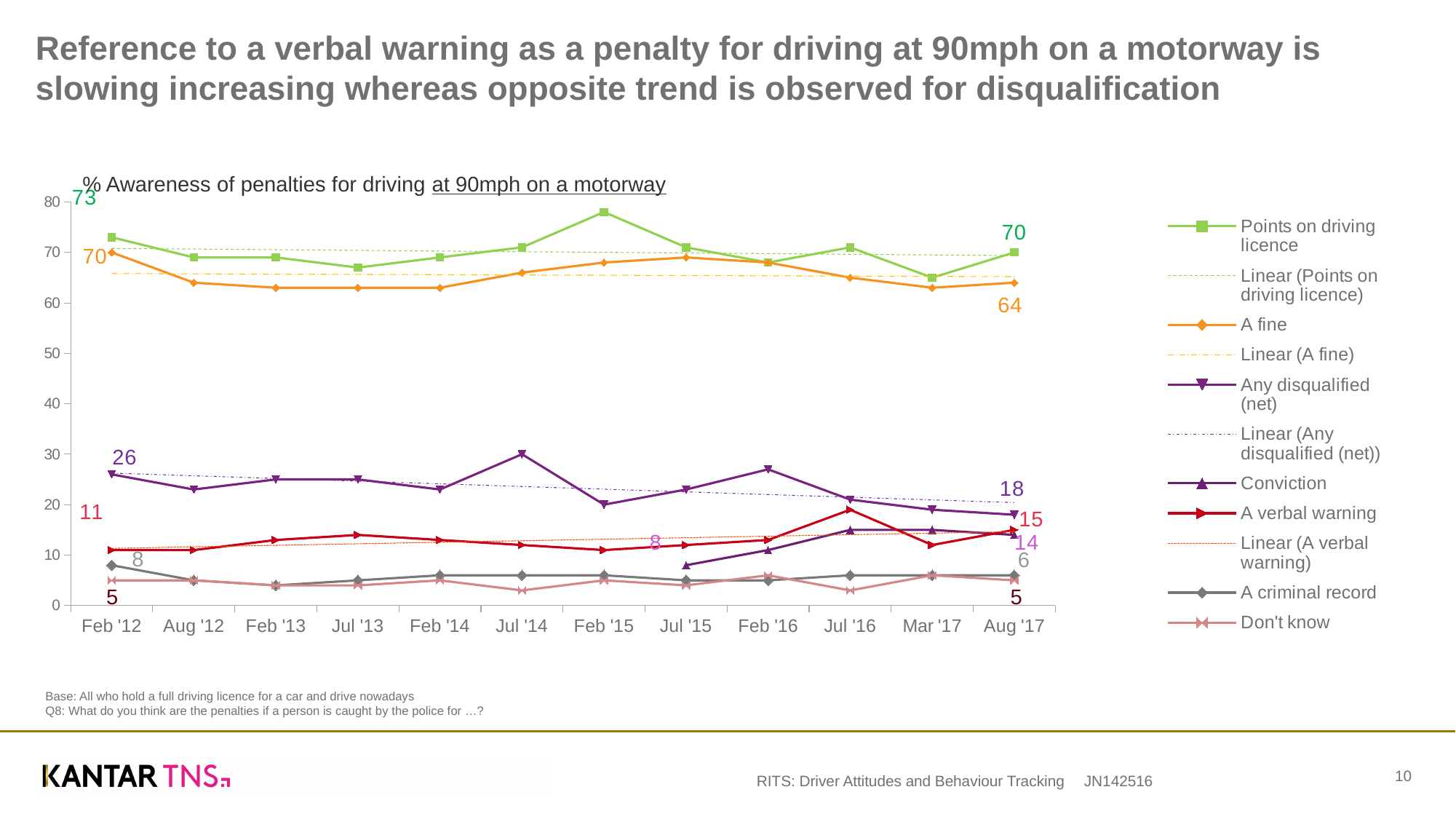
What is the value for Points on driving licence in Feb '12? 73 What is the difference between the Any disqualified (net) values in Feb '12 and Aug '17? 8 Is the value for Points on driving licence in Feb '15 greater or less than 70? greater What is the value for A fine in Aug '17? 64 How many time points are shown on the x axis? 12 How many entries does the legend list? 11 What kind of chart is shown on the slide? line chart Does the value for Any disqualified (net) rise or fall from Feb '12 to Aug '17? fall By how much did the value for Points on driving licence change between Feb '12 and Aug '17? 3 What is the value for Conviction in Jul '15? 8 What is the value for Any disqualified (net) in Feb '12? 26 In Aug '17, which is larger: A verbal warning or Conviction? A verbal warning